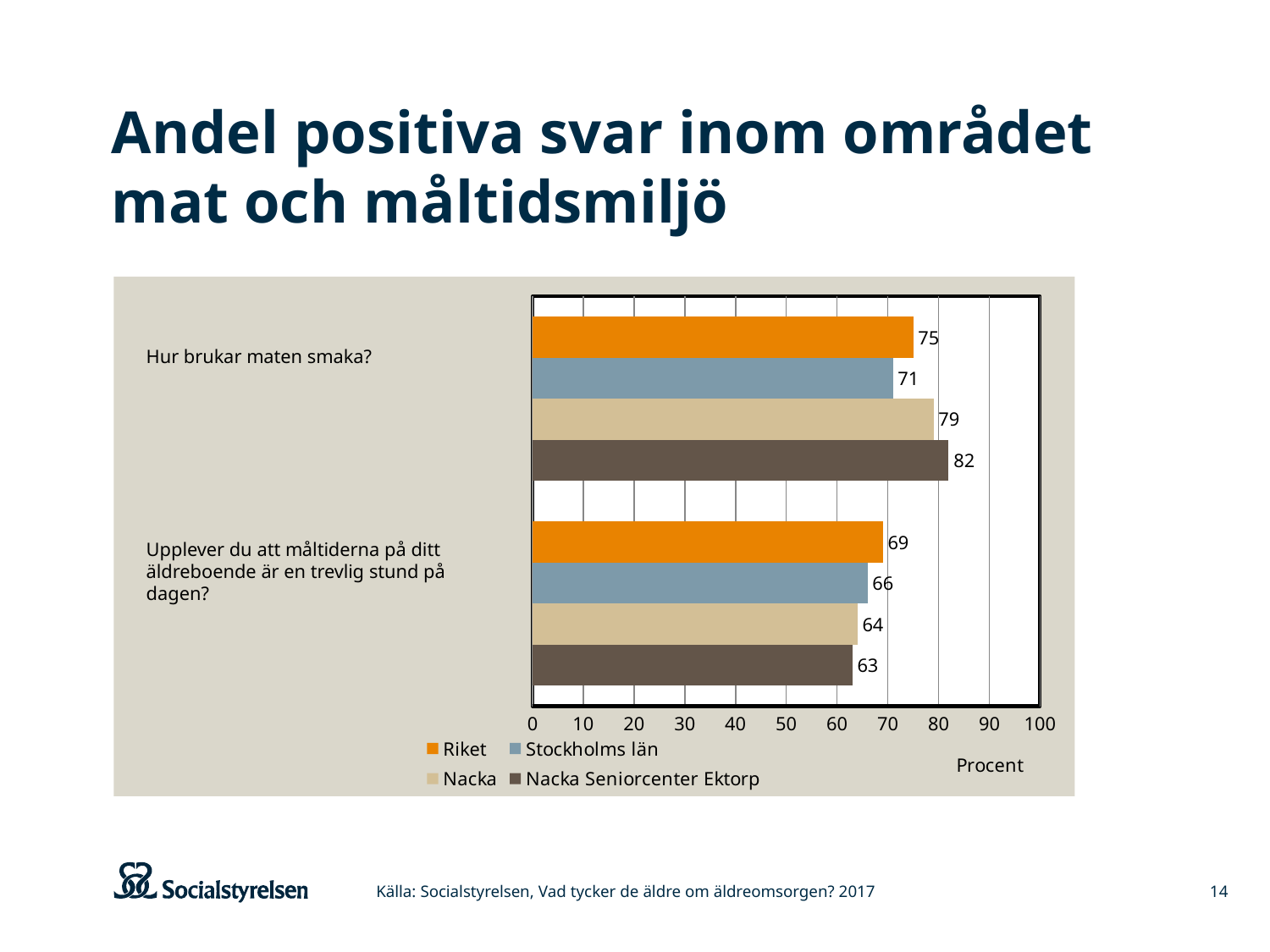
What is the difference between Nacka and Riket for "Hur brukar maten smaka?"? 4 What kind of chart is shown on the slide? Bar chart What is the difference between the Nacka Seniorcenter Ektorp values for the two questions? 19 For "Upplever du att måltiderna på ditt äldreboende är en trevlig stund på dagen?", which is larger: Riket or Nacka? Riket What is the label of the horizontal axis? Procent What value does Nacka Seniorcenter Ektorp have for "Hur brukar maten smaka?"? 82 How many series does the legend list? 4 How many question categories are shown on the chart? 2 What value does Stockholms län have for "Hur brukar maten smaka?"? 71 Which series has the lowest value for "Upplever du att måltiderna på ditt äldreboende är en trevlig stund på dagen?"? Nacka Seniorcenter Ektorp Which series has the highest value for "Hur brukar maten smaka?"? Nacka Seniorcenter Ektorp What value does Riket have for "Upplever du att måltiderna på ditt äldreboende är en trevlig stund på dagen?"? 69